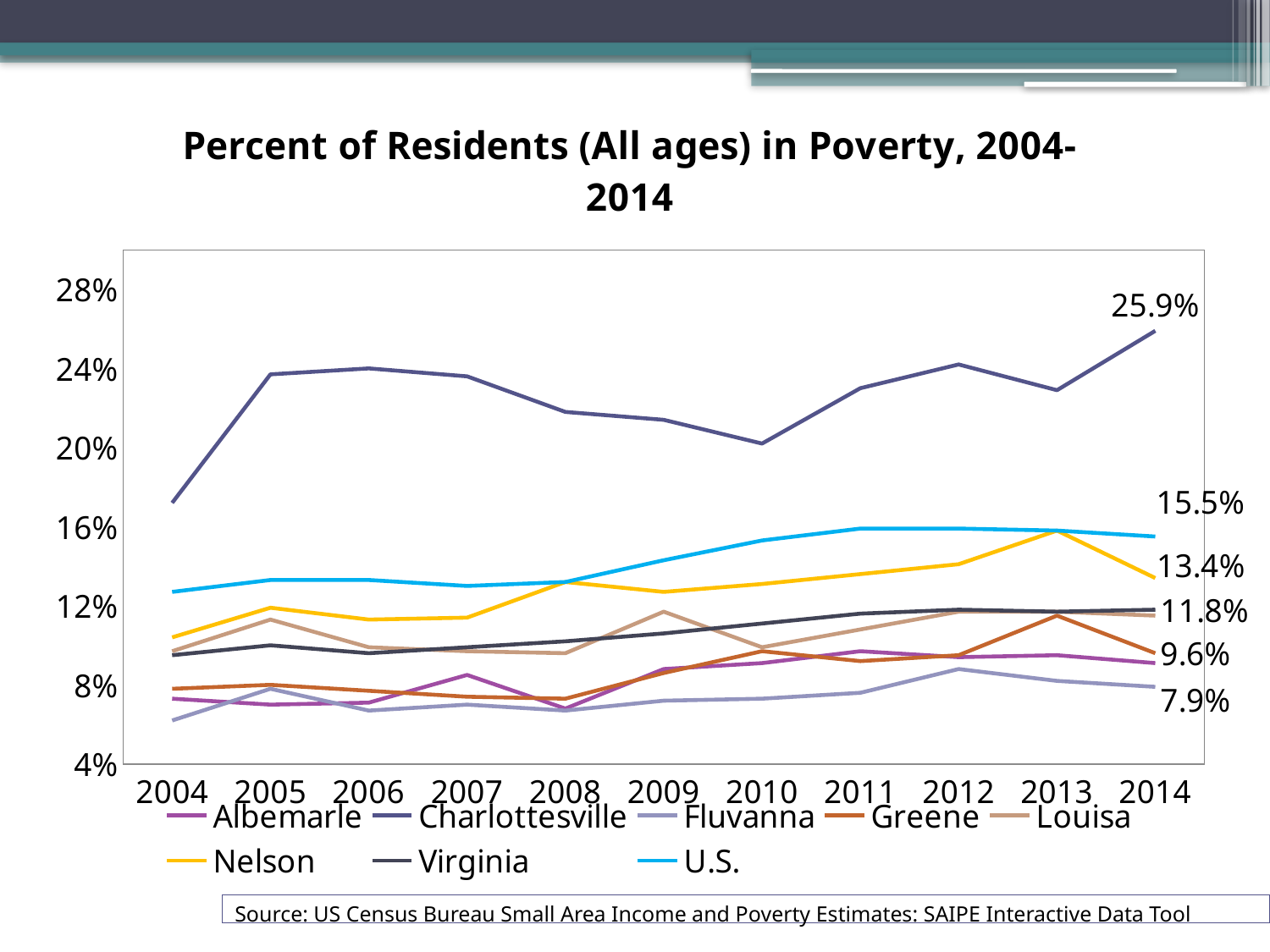
How many series does the legend list? 8 Is the value for Charlottesville in 2010 greater or less than 24%? less What is the poverty rate for Fluvanna in 2014? 7.9% How much higher is Charlottesville's 2014 poverty rate than the U.S. rate in 2014? 10.4 percentage points What is the poverty rate for Charlottesville in 2014? 25.9% Which series has the highest poverty rate in 2014? Charlottesville Does the Charlottesville line rise or fall from 2010 to 2014? rise Which series has the lowest poverty rate in 2014? Fluvanna What is the poverty rate for the U.S. in 2014? 15.5% What is the poverty rate for Nelson in 2014? 13.4% How many years are shown along the x axis? 11 What kind of chart is shown on the slide? line chart